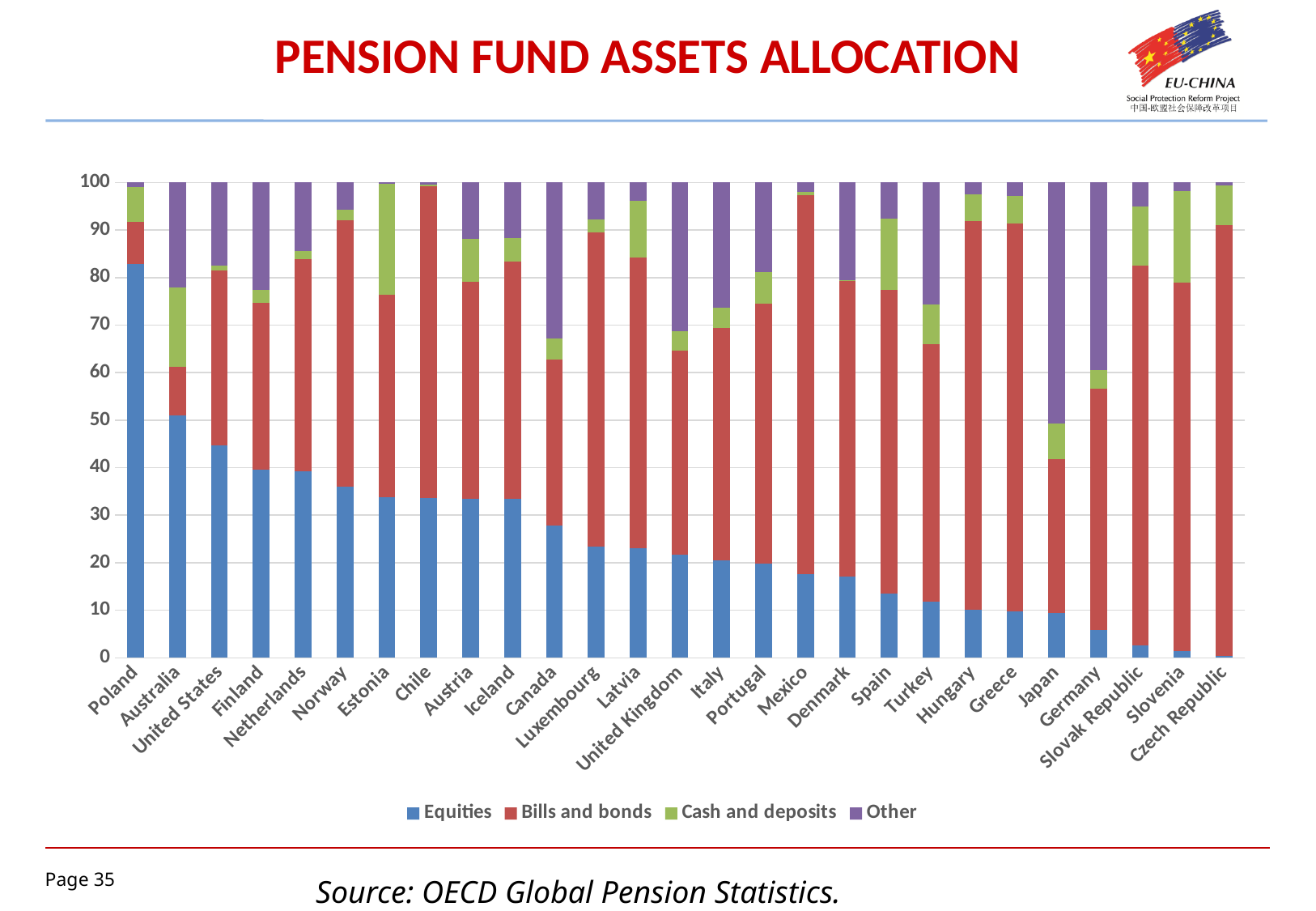
How many countries are shown on the x axis? 27 Do the Equities values rise or fall moving from left to right along the x axis? Fall Which country has the lowest Equities share? Czech Republic Which series is shown in blue in the legend? Equities Is the Equities value for Slovak Republic greater or less than 10? less Which country has the highest Equities share? Poland Is the Equities value for Poland greater or less than 80? greater What kind of chart is shown on the slide? Stacked bar chart Which has the larger Equities share, Poland or Australia? Poland Is the Equities value for Germany greater or less than 10? less How many series does the legend list? 4